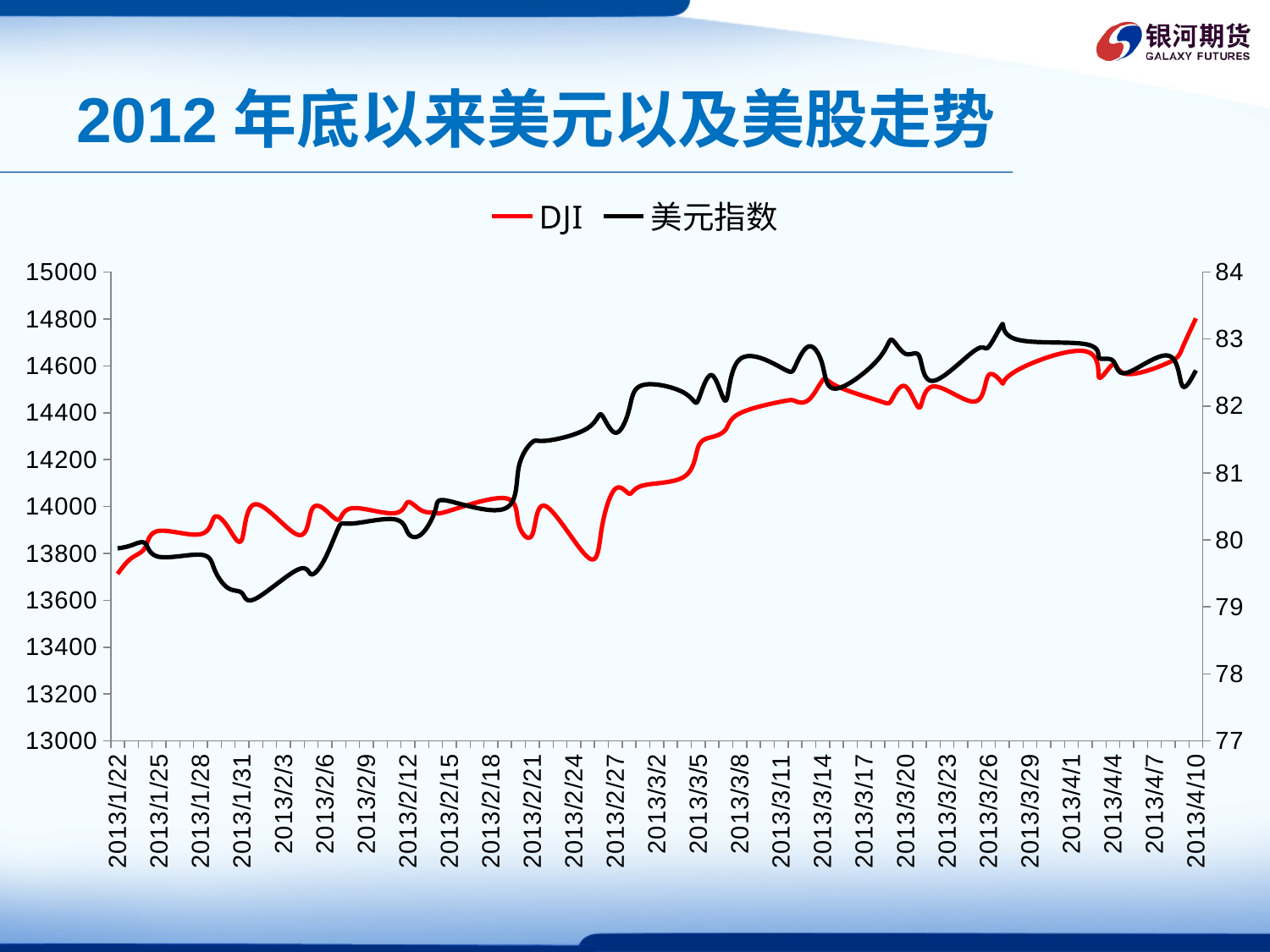
Is the DJI value around 2013/3/8 greater or less than 14200? greater Is the DJI value at 2013/4/10 greater or less than 14600? greater What is the title of the chart on the slide? 2012 年底以来美元以及美股走势 Is the DJI value at 2013/1/22 greater or less than 14000? less Overall, does the DJI series rise or fall from 2013/1/22 to 2013/4/10? rise What kind of chart is shown on the slide? line chart How many series does the legend list? 2 Overall, does the 美元指数 series rise or fall from 2013/1/22 to 2013/4/10? rise Which colour is used for the DJI series? red